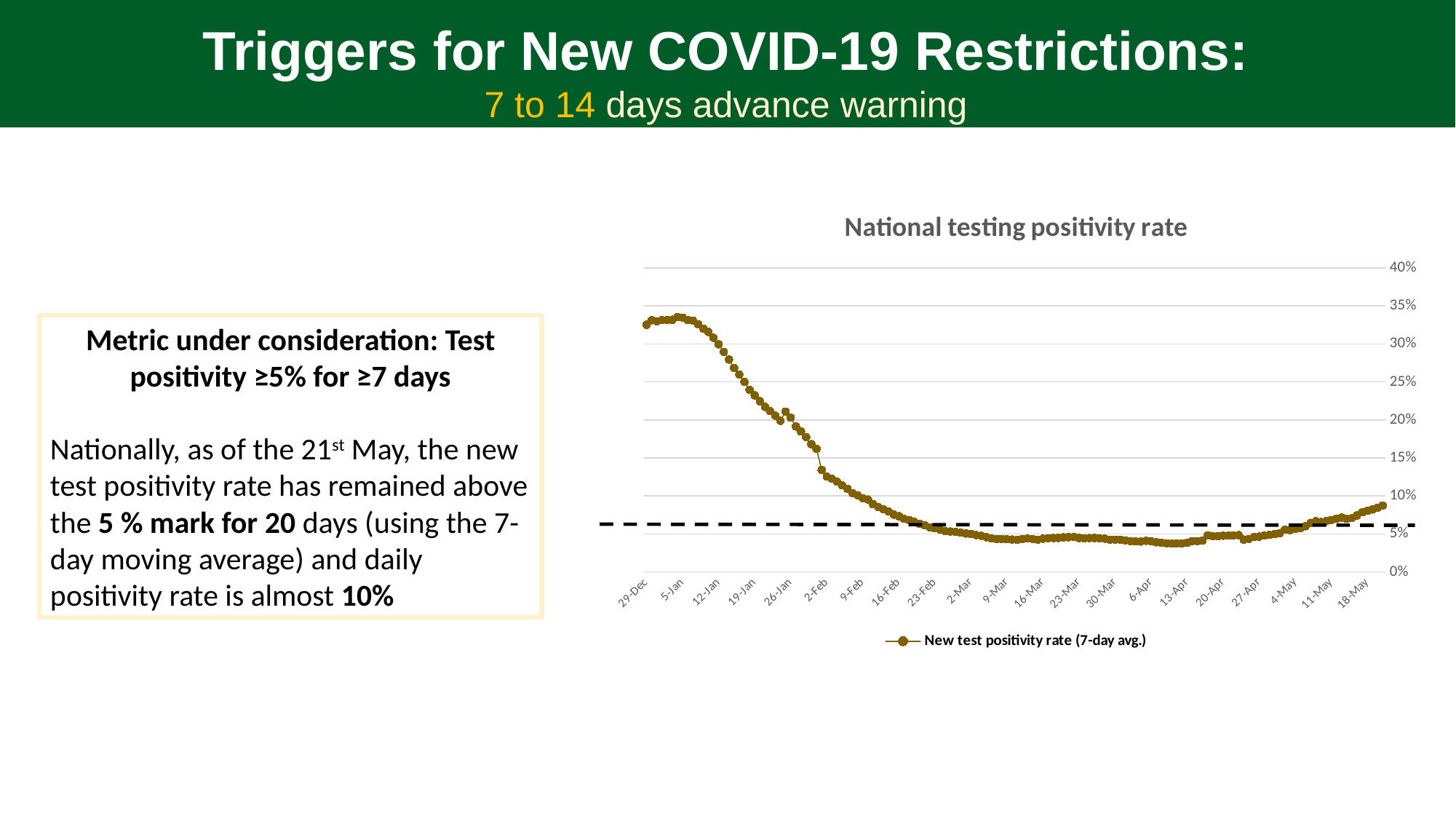
Is the positivity rate at 19-Jan greater or less than 20%? greater Is the positivity rate higher at 5-Jan or at 18-May? 5-Jan Is the positivity rate at 2-Feb greater or less than 10%? greater What kind of chart is shown on the slide? Line chart Does the positivity rate rise or fall between 29-Dec and 9-Mar? Fall How many series does the chart legend list? 1 Is the positivity rate at 9-Mar greater or less than 5%? less Does the positivity rate rise or fall between 13-Apr and 18-May? Rise What is the name of the series shown in the chart legend? New test positivity rate (7-day avg.) What is the title of the chart? National testing positivity rate